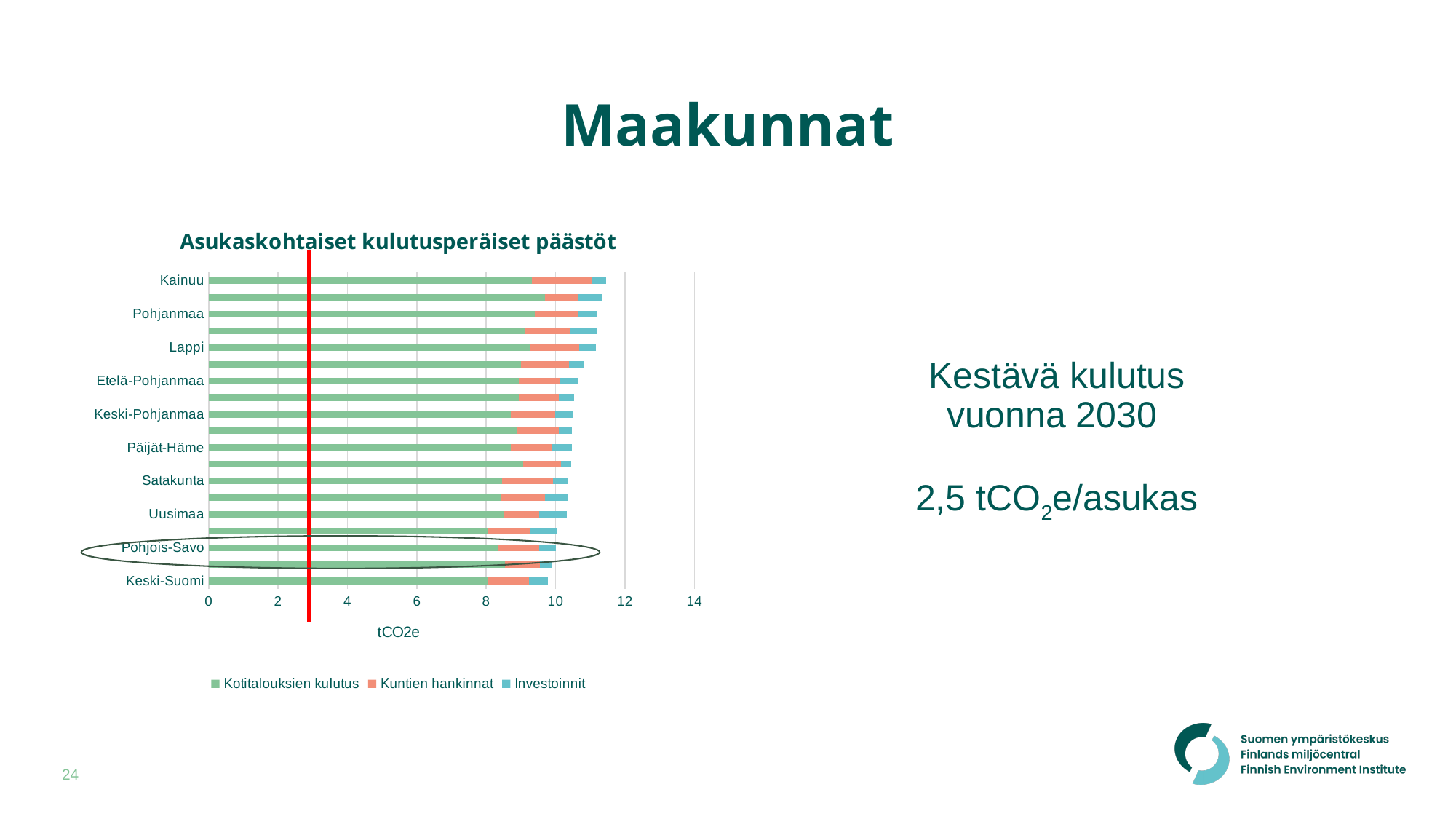
What kind of chart is shown on the slide? Stacked bar chart What are the three series listed in the chart legend? Kotitalouksien kulutus, Kuntien hankinnat, Investoinnit What is the title of the chart? Asukaskohtaiset kulutusperäiset päästöt Do the total bar lengths increase or decrease going from the top of the chart to the bottom? decrease How many bars are plotted in the chart? 19 Is the Kotitalouksien kulutus value for Kainuu greater or less than 8 tCO2e? greater Is the total value for Kainuu greater or less than 10 tCO2e? greater Is the total value for Keski-Suomi greater or less than 12 tCO2e? less How many series does the legend of the chart list? 3 Which has a larger total value, Kainuu or Keski-Suomi? Kainuu Which labelled region has the lowest total per-capita emissions in the chart? Keski-Suomi Which labelled region has the highest total per-capita emissions in the chart? Kainuu